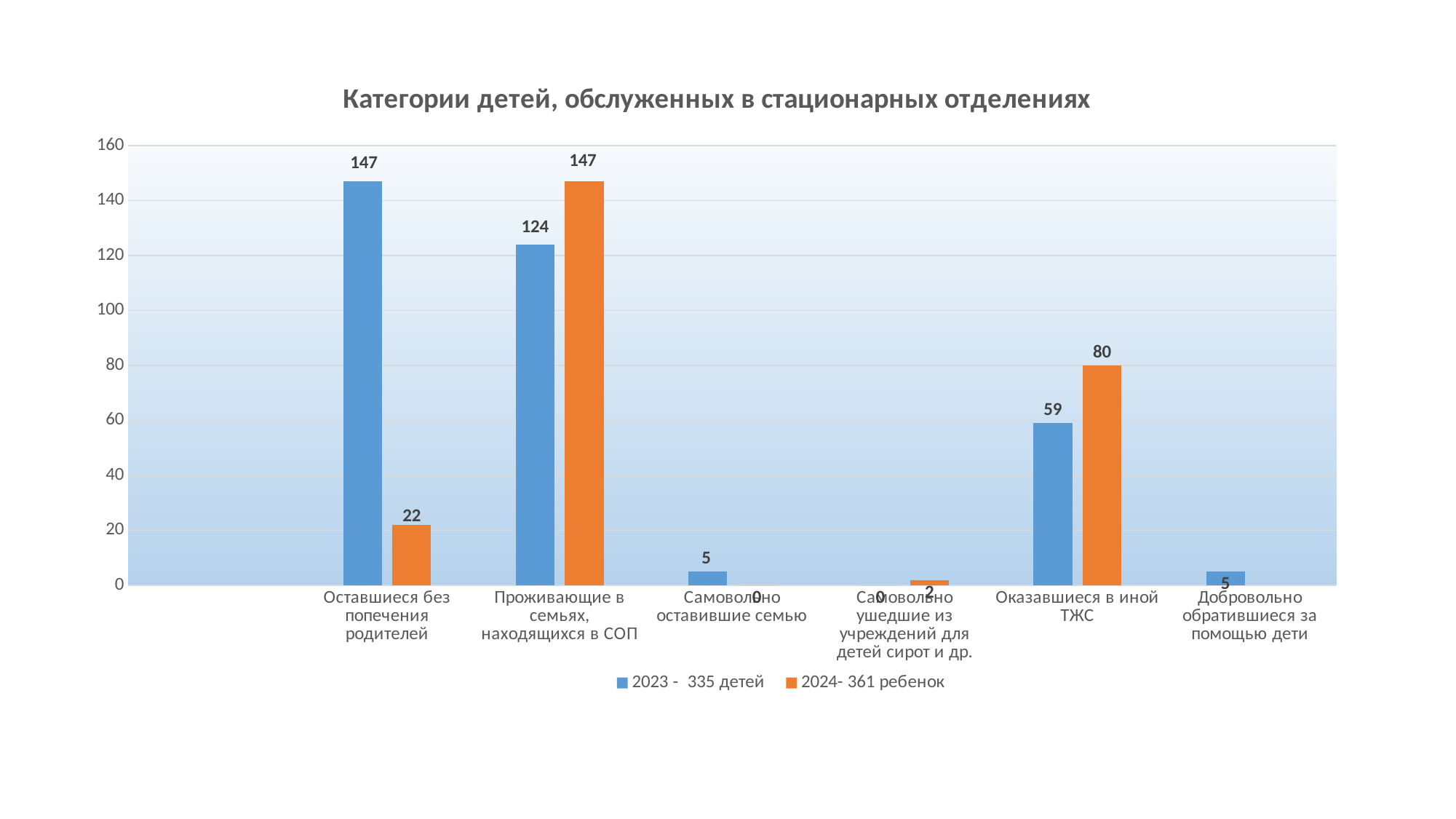
What is the 2024 value for 'Оставшиеся без попечения родителей'? 22 What is the 2024 value for 'Оказавшиеся в иной ТЖС'? 80 How many series does the legend list? 2 Which category has the highest 2023 value? Оставшиеся без попечения родителей What is the difference between the 2023 and 2024 values for 'Оставшиеся без попечения родителей'? 125 How many categories are shown on the x axis? 6 Which category has the highest 2024 value? Проживающие в семьях, находящихся в СОП For 'Проживающие в семьях, находящихся в СОП', which year has the larger value, 2023 or 2024? 2024 What is the 2023 value for 'Проживающие в семьях, находящихся в СОП'? 124 What is the difference between the 2024 and 2023 values for 'Оказавшиеся в иной ТЖС'? 21 What type of chart is shown on the slide? Bar chart What is the 2023 value for 'Оставшиеся без попечения родителей'? 147